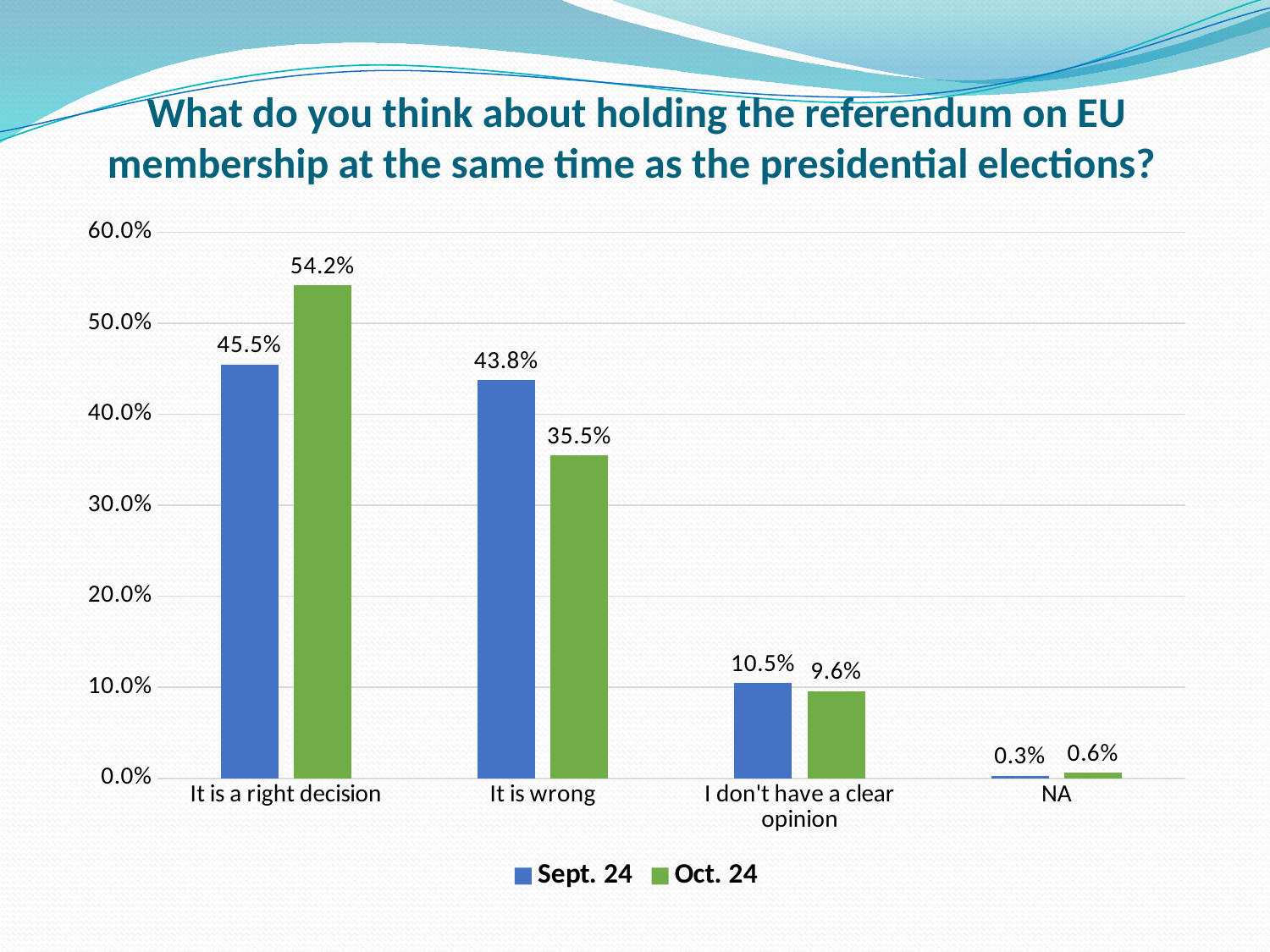
What is the Oct. 24 value for "It is a right decision"? 54.2% What kind of chart is shown on the slide? Bar chart Which category has the lowest Sept. 24 value? NA What is the Oct. 24 value for "I don't have a clear opinion"? 9.6% What is the difference between the Oct. 24 and Sept. 24 values for "It is a right decision"? 8.7% Which is larger for "It is wrong": the Sept. 24 value or the Oct. 24 value? Sept. 24 Which series is shown in green in the legend? Oct. 24 What is the Sept. 24 value for "It is wrong"? 43.8% How many categories are shown on the x axis? 4 What is the difference between the Sept. 24 and Oct. 24 values for "It is wrong"? 8.3% How many series does the legend list? 2 Which category has the highest Oct. 24 value? It is a right decision